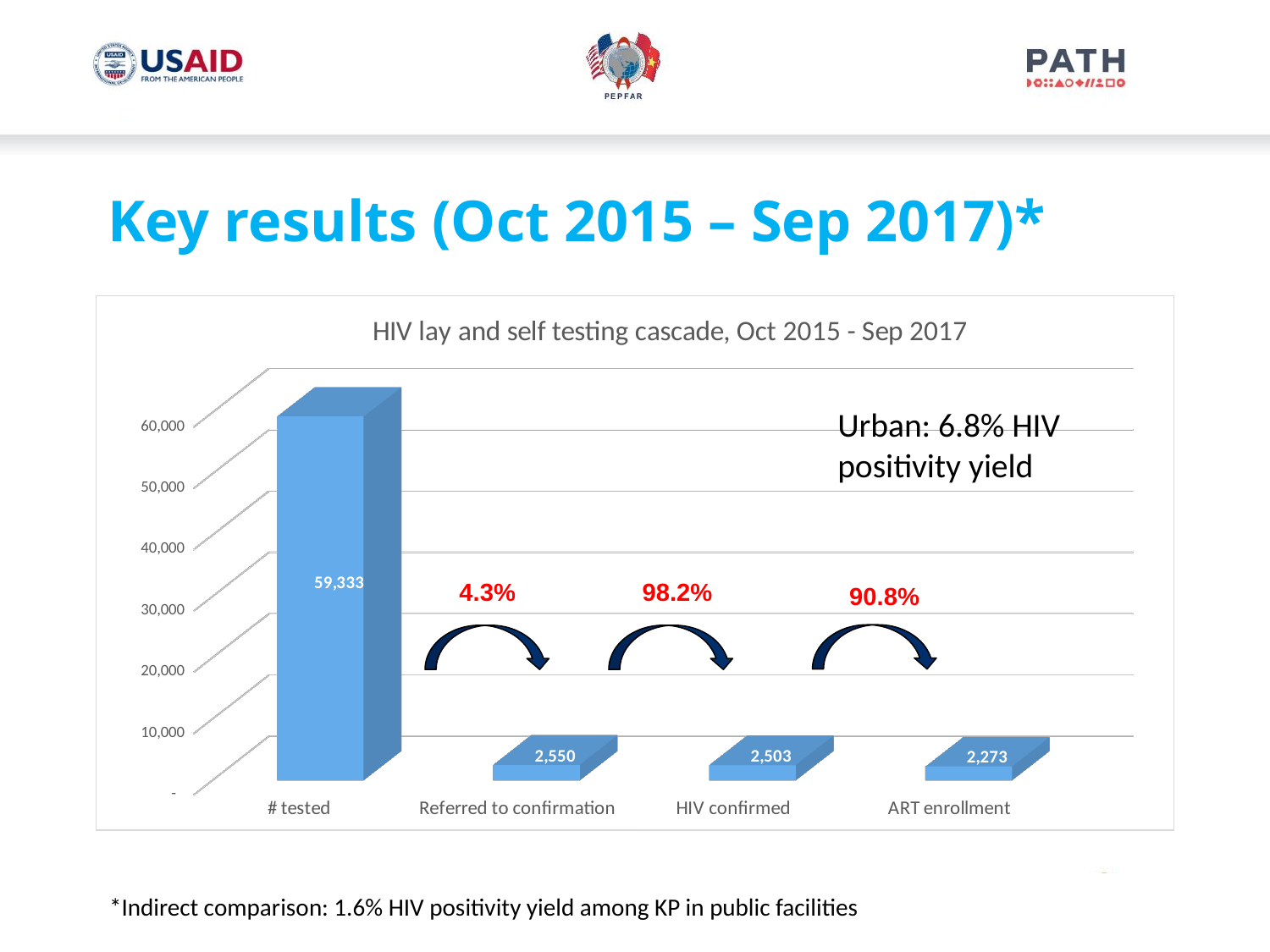
How many categories are shown on the x axis? 4 What is the value for '# tested'? 59,333 What is the value for 'ART enrollment'? 2,273 Which category has the lowest value? ART enrollment What is the title of the chart? HIV lay and self testing cascade, Oct 2015 - Sep 2017 What is the difference between 'Referred to confirmation' and 'HIV confirmed'? 47 What is the value for 'HIV confirmed'? 2,503 What kind of chart is this? Bar chart What is the value for 'Referred to confirmation'? 2,550 Which is larger, 'Referred to confirmation' or 'ART enrollment'? Referred to confirmation What is the difference between 'HIV confirmed' and 'ART enrollment'? 230 Which category has the highest value? # tested